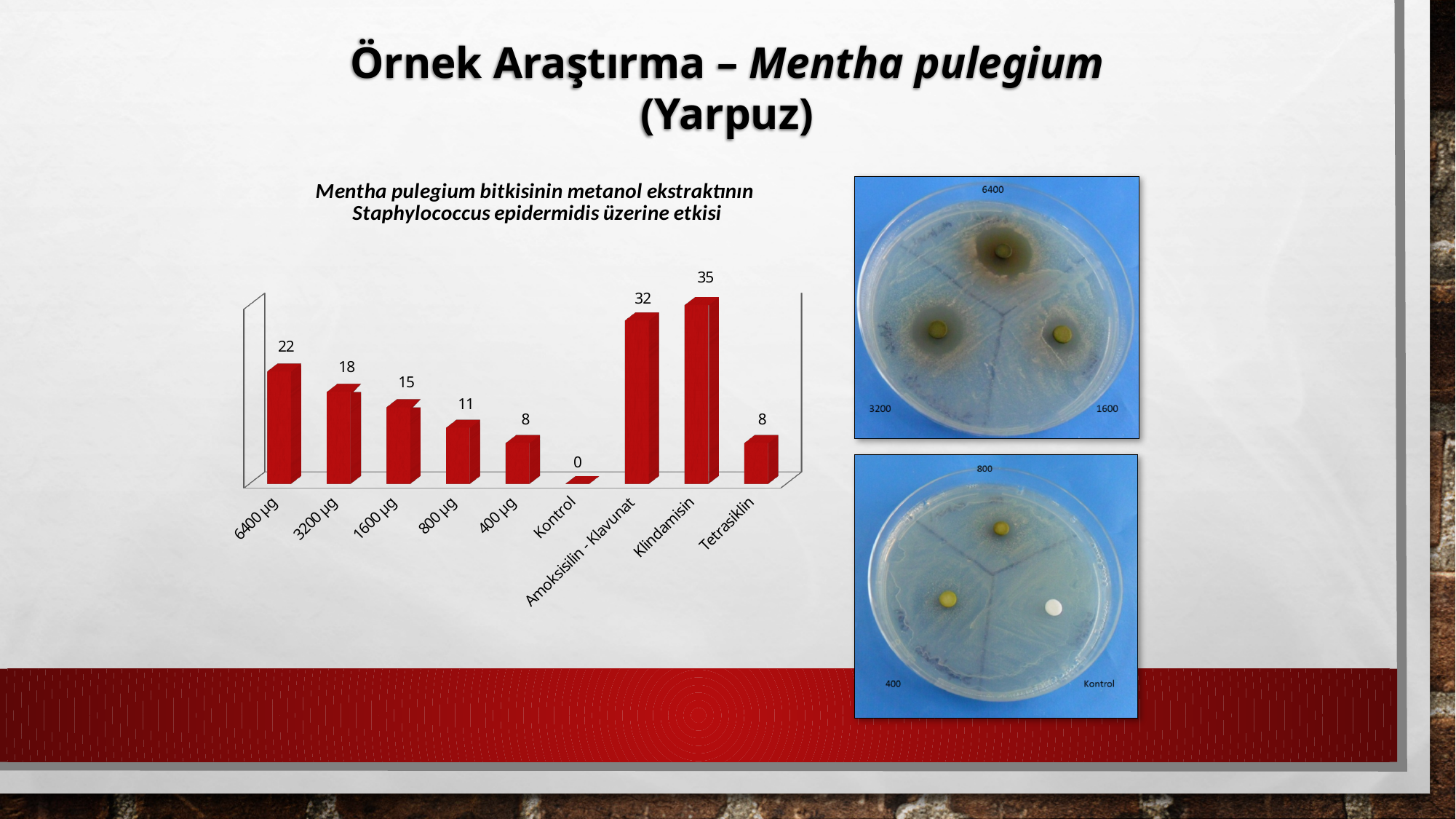
How many categories are shown on the x axis? 9 What is the difference between the values for Klindamisin and Amoksisilin - Klavunat? 3 Which category has the highest value? Klindamisin What is the value for Amoksisilin - Klavunat? 32 What kind of chart is shown on the slide? Bar chart Which is larger, the value for 1600 µg or the value for 800 µg? 1600 µg What is the value for Kontrol? 0 Which category has the lowest value? Kontrol Do the values rise or fall from 6400 µg to 400 µg? Fall What is the difference between the values for 6400 µg and 3200 µg? 4 What is the value for 6400 µg? 22 What is the value for Klindamisin? 35